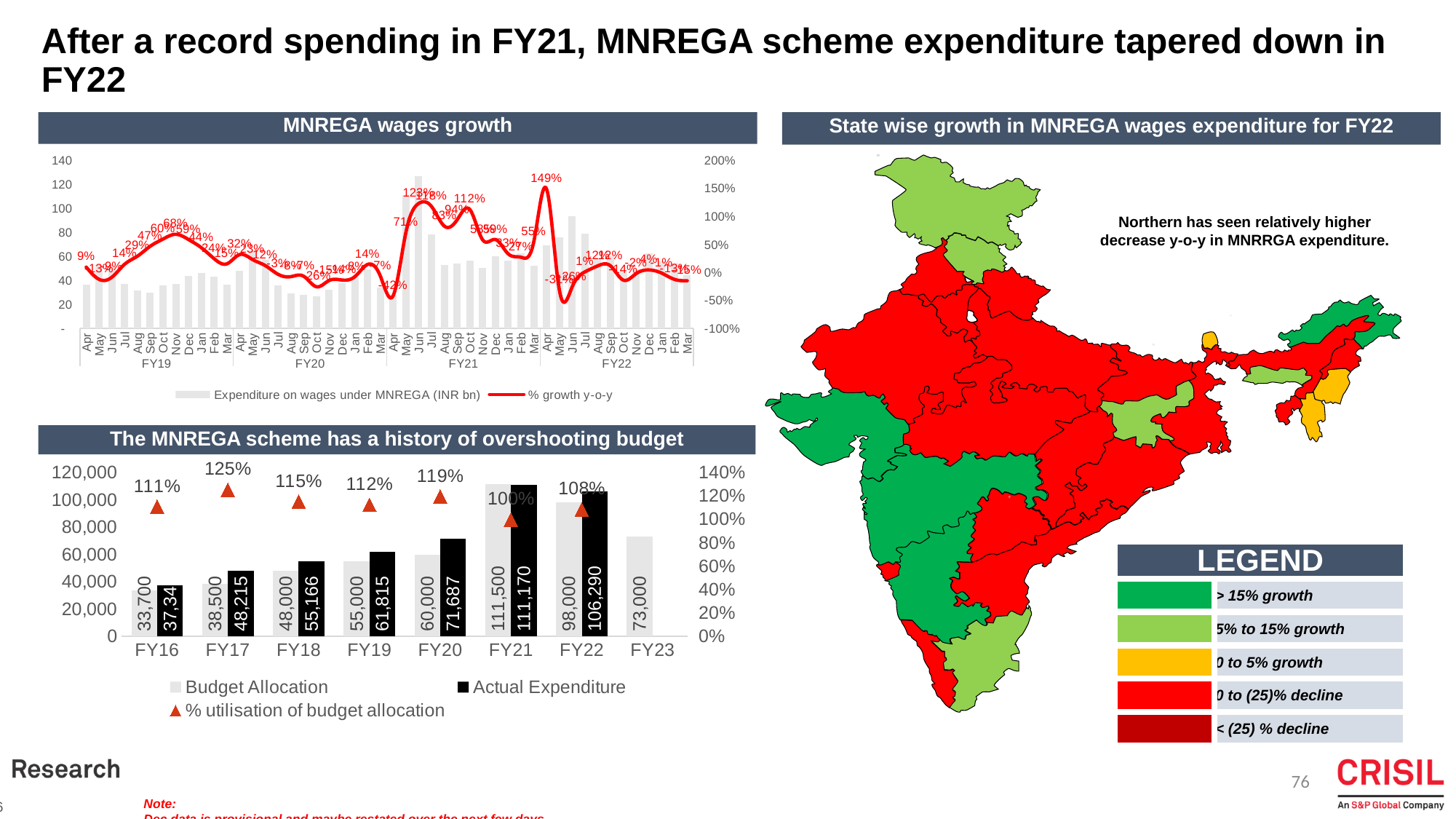
In the chart 'The MNREGA scheme has a history of overshooting budget', what is the % utilisation of budget allocation for FY17? 125% In the chart 'The MNREGA scheme has a history of overshooting budget', which fiscal year has the highest % utilisation of budget allocation? FY17 In the chart 'The MNREGA scheme has a history of overshooting budget', which fiscal year has the lowest % utilisation of budget allocation? FY21 How many series does the legend of the chart 'MNREGA wages growth' list? 2 In the chart 'The MNREGA scheme has a history of overshooting budget', by how much did Actual Expenditure exceed Budget Allocation in FY20? 11,687 In the chart 'The MNREGA scheme has a history of overshooting budget', what is the Actual Expenditure for FY22? 106,290 How many series does the legend of the chart 'The MNREGA scheme has a history of overshooting budget' list? 3 How many fiscal years are shown on the x-axis of the chart 'The MNREGA scheme has a history of overshooting budget'? 8 In the chart 'The MNREGA scheme has a history of overshooting budget', by how much did Actual Expenditure exceed Budget Allocation in FY22? 8,290 In the chart 'MNREGA wages growth', what is the highest % growth y-o-y value labelled on the line? 149% In the chart 'The MNREGA scheme has a history of overshooting budget', which is larger for FY21: Budget Allocation or Actual Expenditure? Budget Allocation In the chart 'The MNREGA scheme has a history of overshooting budget', what is the Budget Allocation for FY21? 111,500